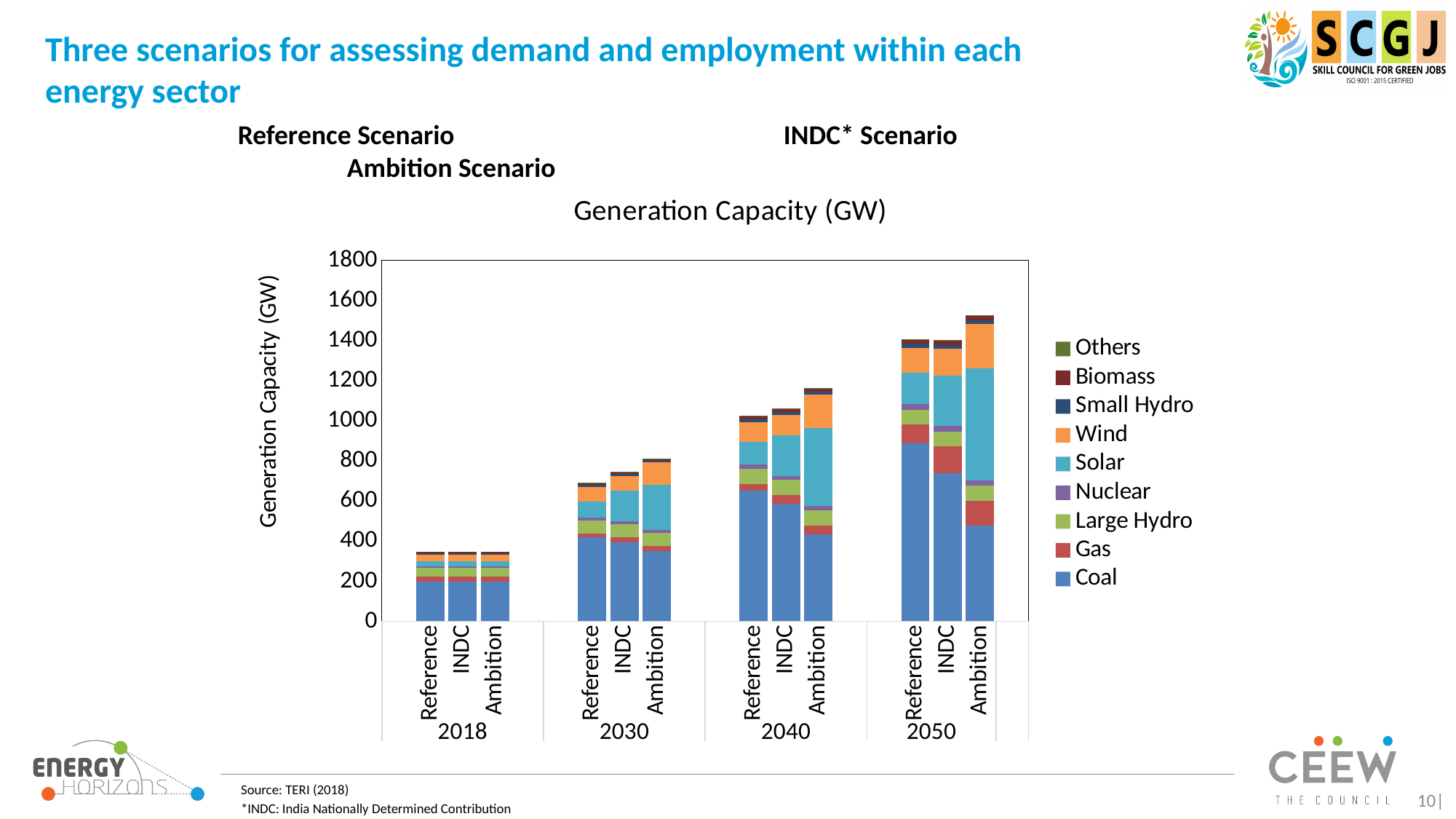
Is the total generation capacity for the 2040 Ambition bar greater or less than 1000? greater Do the total generation capacities for the Reference scenario rise or fall from 2018 to 2050? rise What kind of chart is shown on the slide? Stacked bar chart Is the total generation capacity for the 2018 Reference bar greater or less than 400? less Is the total generation capacity for the 2050 Ambition bar greater or less than 1400? greater In 2030, which bar has the larger total generation capacity, Reference or Ambition? Ambition What is the title of the chart? Generation Capacity (GW) Which bar has the highest total generation capacity? Ambition, 2050 How many series does the legend of the Generation Capacity (GW) chart list? 9 In 2050, which bar has the larger Coal segment, Reference or Ambition? Reference How many bars are plotted in the Generation Capacity (GW) chart? 12